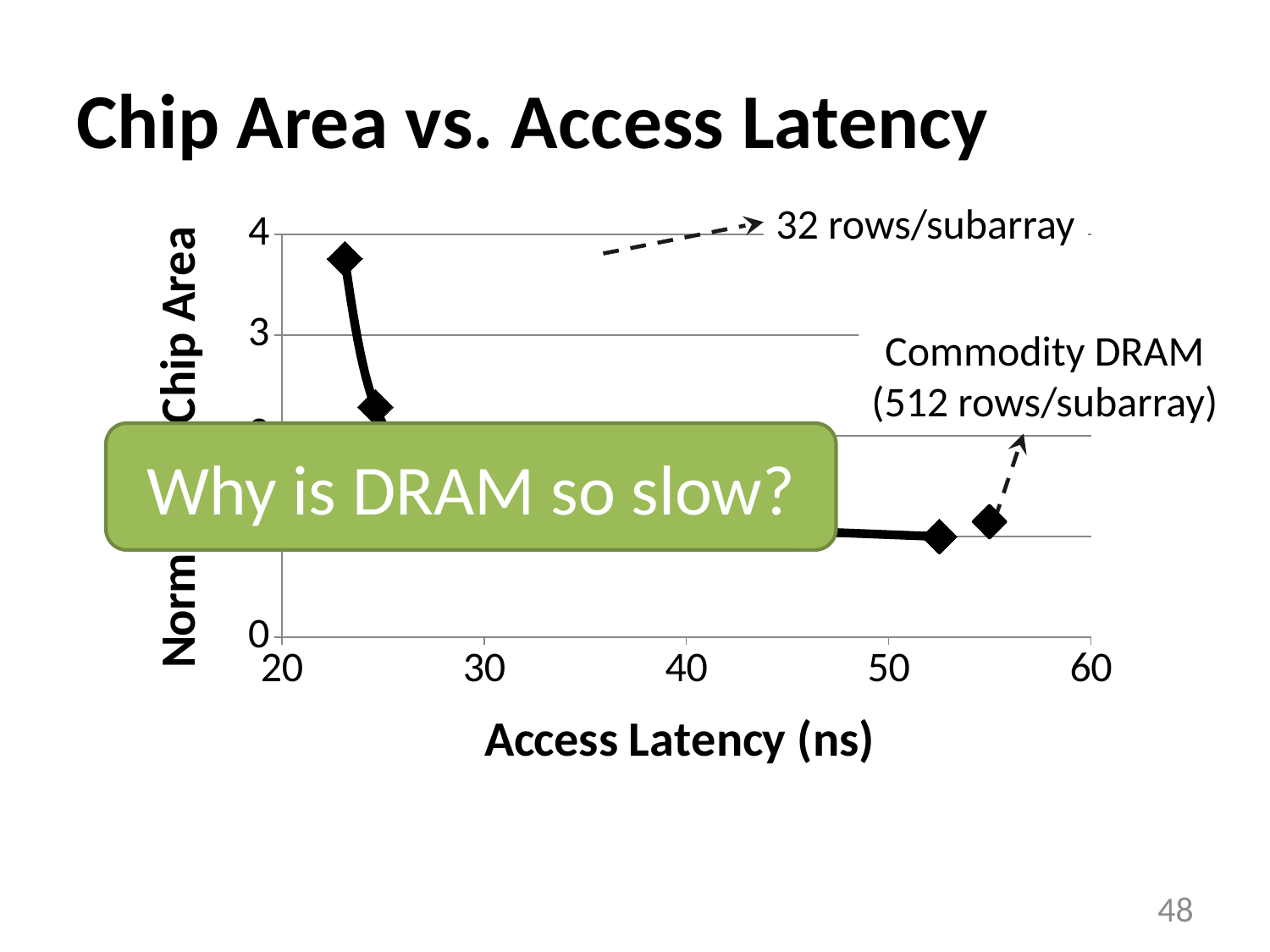
Which point on the chart has the highest normalized chip area? 32 rows/subarray Is the access latency of the Commodity DRAM (512 rows/subarray) point greater or less than 50 ns? greater Overall, does the normalized chip area rise or fall as access latency increases along the x axis? fall What is the title of the chart? Chip Area vs. Access Latency Which configuration has the larger normalized chip area, 32 rows/subarray or Commodity DRAM (512 rows/subarray)? 32 rows/subarray What is the label of the x axis? Access Latency (ns) Is the access latency of the 32 rows/subarray point greater or less than 30 ns? less Is the normalized chip area for the Commodity DRAM (512 rows/subarray) point greater or less than 2? less Which configuration has the higher access latency, 32 rows/subarray or Commodity DRAM (512 rows/subarray)? Commodity DRAM (512 rows/subarray) What kind of chart is shown on the slide? line chart